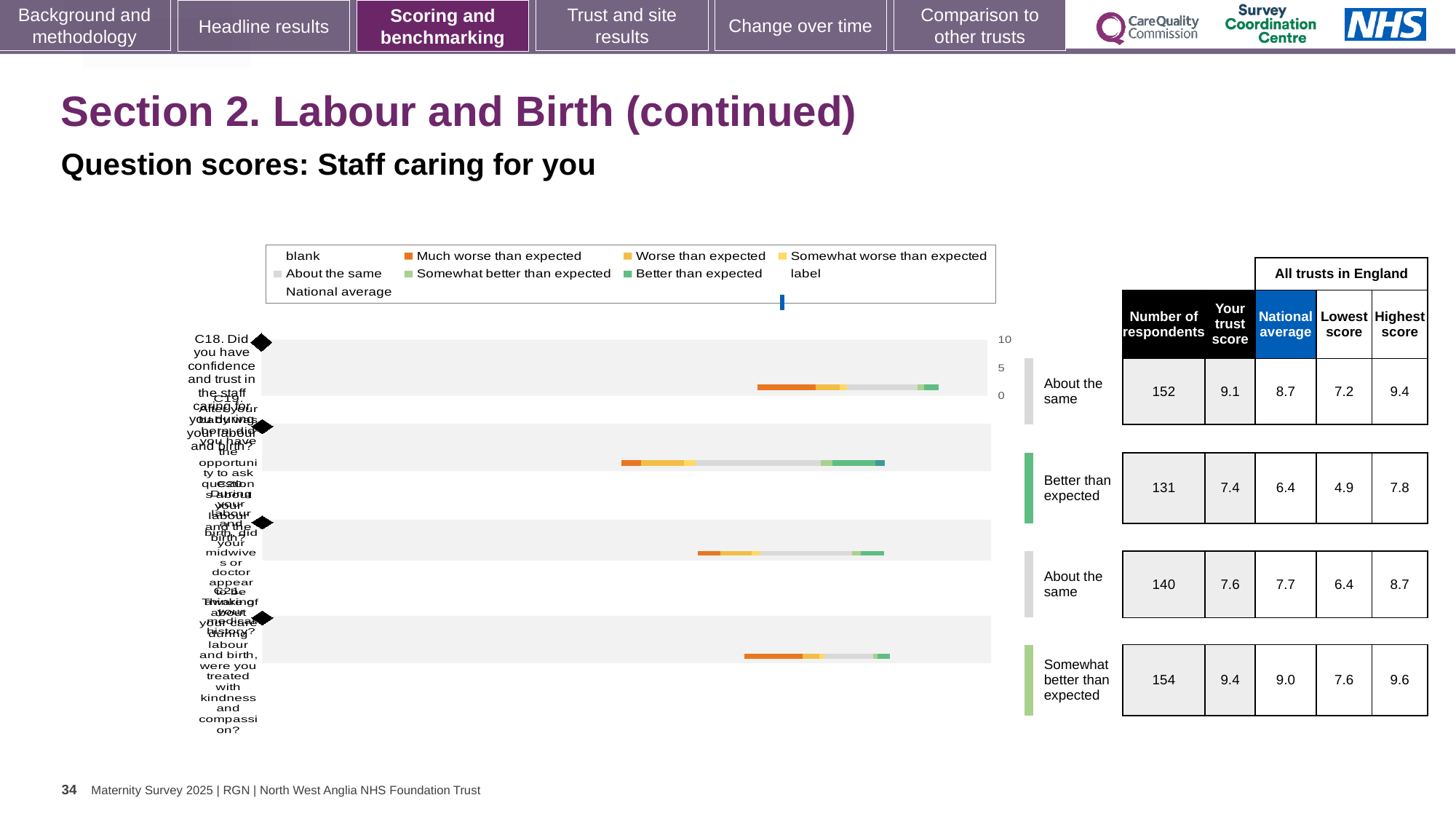
In the table on the right, what is the national average for the 'Somewhat better than expected' row? 9.0 In the table on the right, for the third row (140 respondents), which is larger: the trust score or the national average? national average In the table on the right, what is the number of respondents for the first row (About the same)? 152 What kind of chart is shown on the slide? bar chart In the table on the right, which row has the lowest number of respondents? Better than expected (131) In the table on the right, what is the highest score for the third row (About the same, 140 respondents)? 8.7 In the chart legend, what colour represents 'Much worse than expected'? orange In the table on the right, which row has the highest trust score? Somewhat better than expected (9.4) In the table on the right, what is the difference between the trust score and the national average for the first row? 0.4 What is the subtitle above the chart? Question scores: Staff caring for you How many question bars are plotted in the chart? 4 In the table on the right, what is the trust score for the 'Better than expected' row? 7.4